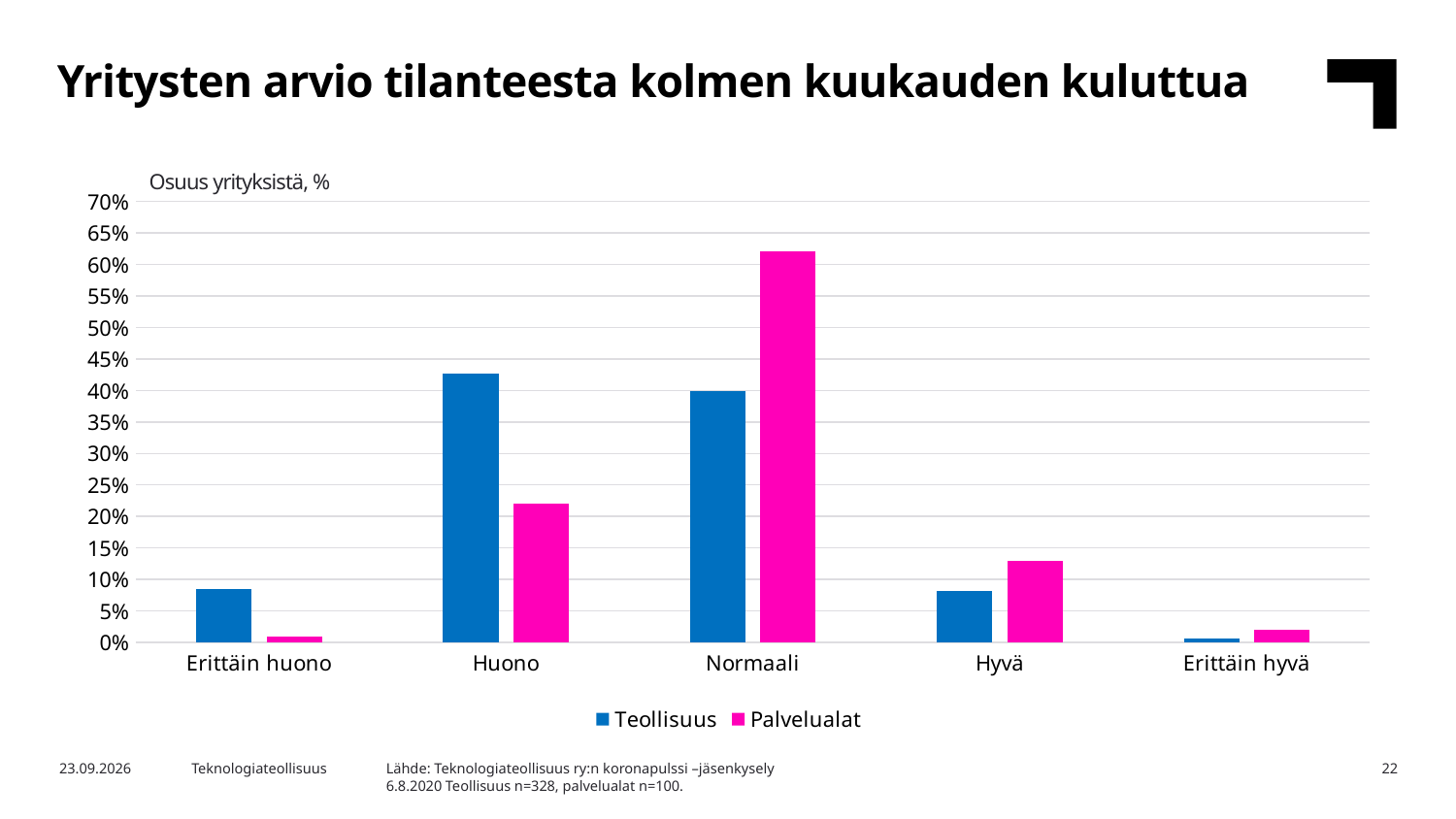
How many categories are shown on the x axis of the chart? 5 Is the Palvelualat value for Huono greater or less than 25%? less For the Huono category, which series has the larger value, Teollisuus or Palvelualat? Teollisuus How many series does the legend list? 2 Is the Teollisuus value for Erittäin huono greater or less than 10%? less Which category has the lowest value for the Teollisuus series? Erittäin hyvä For the Normaali category, which series has the larger value, Teollisuus or Palvelualat? Palvelualat What kind of chart is shown on the slide? bar chart Is the Palvelualat value for Normaali greater or less than 60%? greater Which category has the highest value for the Palvelualat series? Normaali For the Hyvä category, which series has the larger value, Teollisuus or Palvelualat? Palvelualat What is the title of the chart on the slide? Yritysten arvio tilanteesta kolmen kuukauden kuluttua